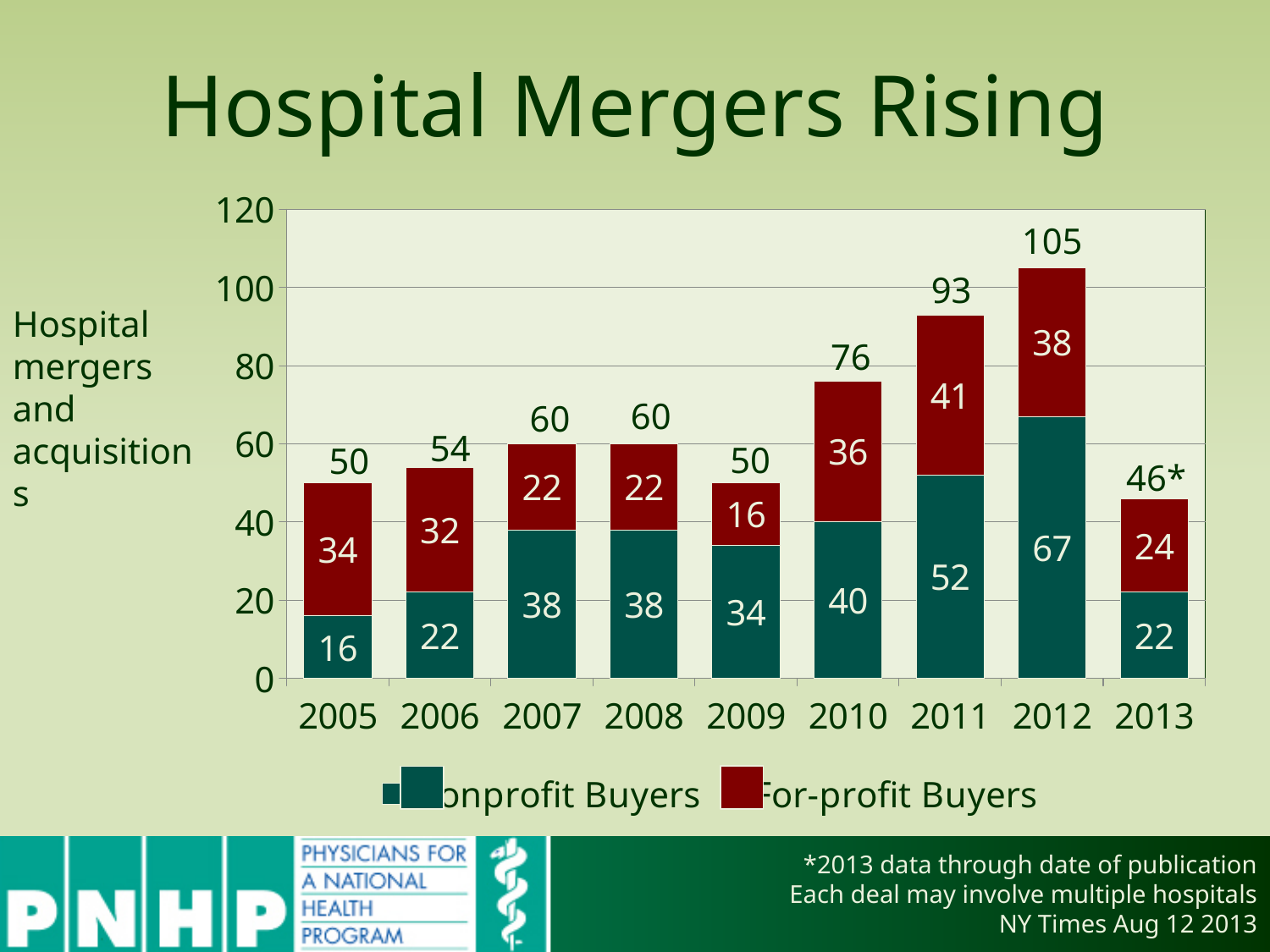
What colour represents For-profit Buyers in the chart? Dark red What is the value for Nonprofit Buyers in 2012? 67 What is the difference between the Nonprofit Buyers value and the For-profit Buyers value in 2005? 18 How many series does the legend list? 2 What is the total of the stacked bar for 2010? 76 How many years are shown on the x axis? 9 What is the value for For-profit Buyers in 2011? 41 What kind of chart is shown on the slide? Stacked bar chart Which year has the lowest value for Nonprofit Buyers? 2005 Which year has the highest total of hospital mergers and acquisitions? 2012 Do the total values rise or fall from 2009 to 2012? Rise Which is larger in 2009: Nonprofit Buyers or For-profit Buyers? Nonprofit Buyers